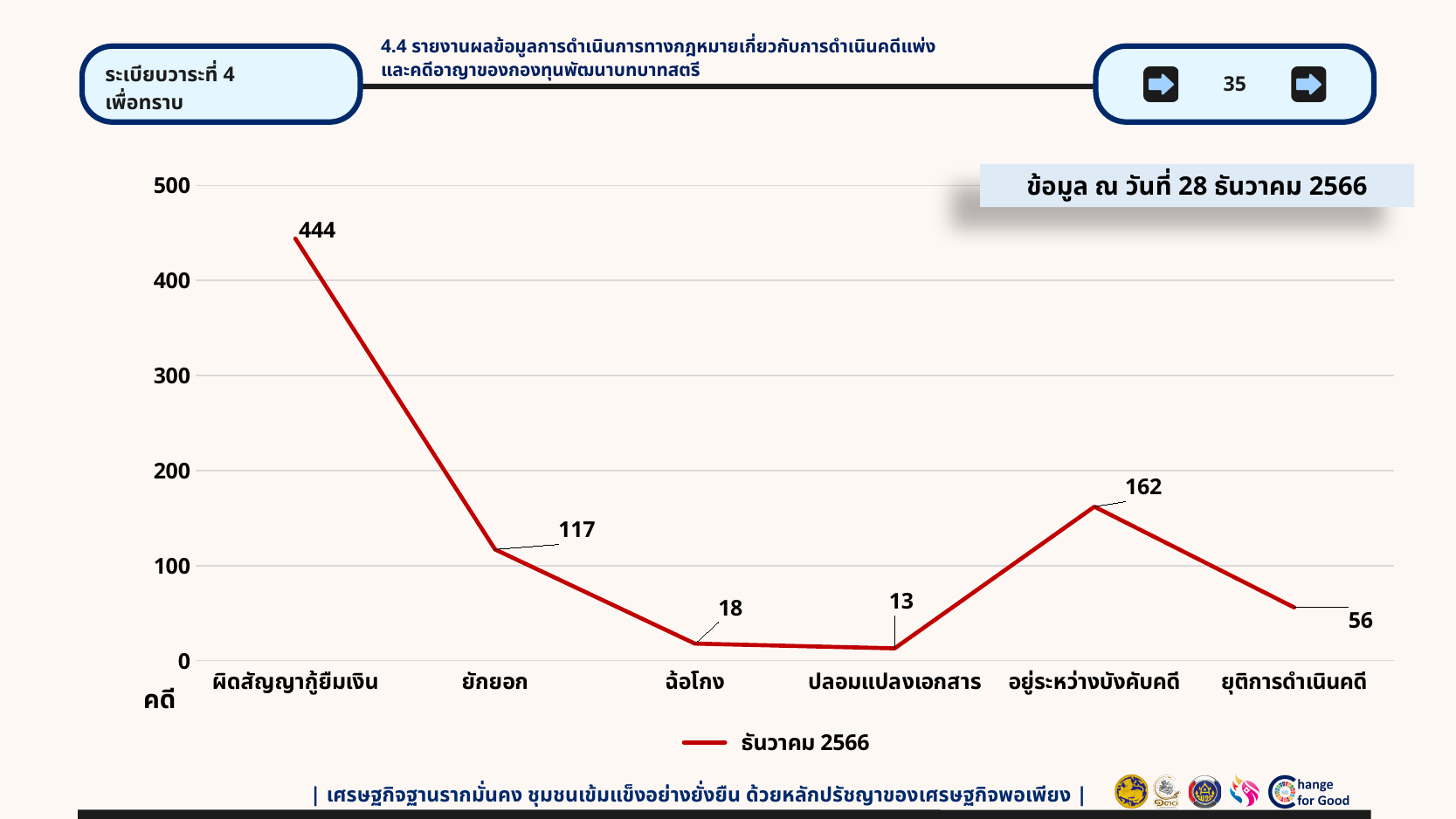
What is the value for อยู่ระหว่างบังคับคดี? 162 Which is larger, the value for ฉ้อโกง or the value for ปลอมแปลงเอกสาร? ฉ้อโกง What series name does the legend show? ธันวาคม 2566 What kind of chart is shown on the slide? line chart Is the value for อยู่ระหว่างบังคับคดี greater or less than 200? less How many categories are shown on the x axis? 6 What is the value for ยุติการดำเนินคดี? 56 Which category has the highest value? ผิดสัญญากู้ยืมเงิน What is the value for ผิดสัญญากู้ยืมเงิน? 444 What is the value for ยักยอก? 117 Which category has the lowest value? ปลอมแปลงเอกสาร What is the difference between the values for ผิดสัญญากู้ยืมเงิน and ยักยอก? 327